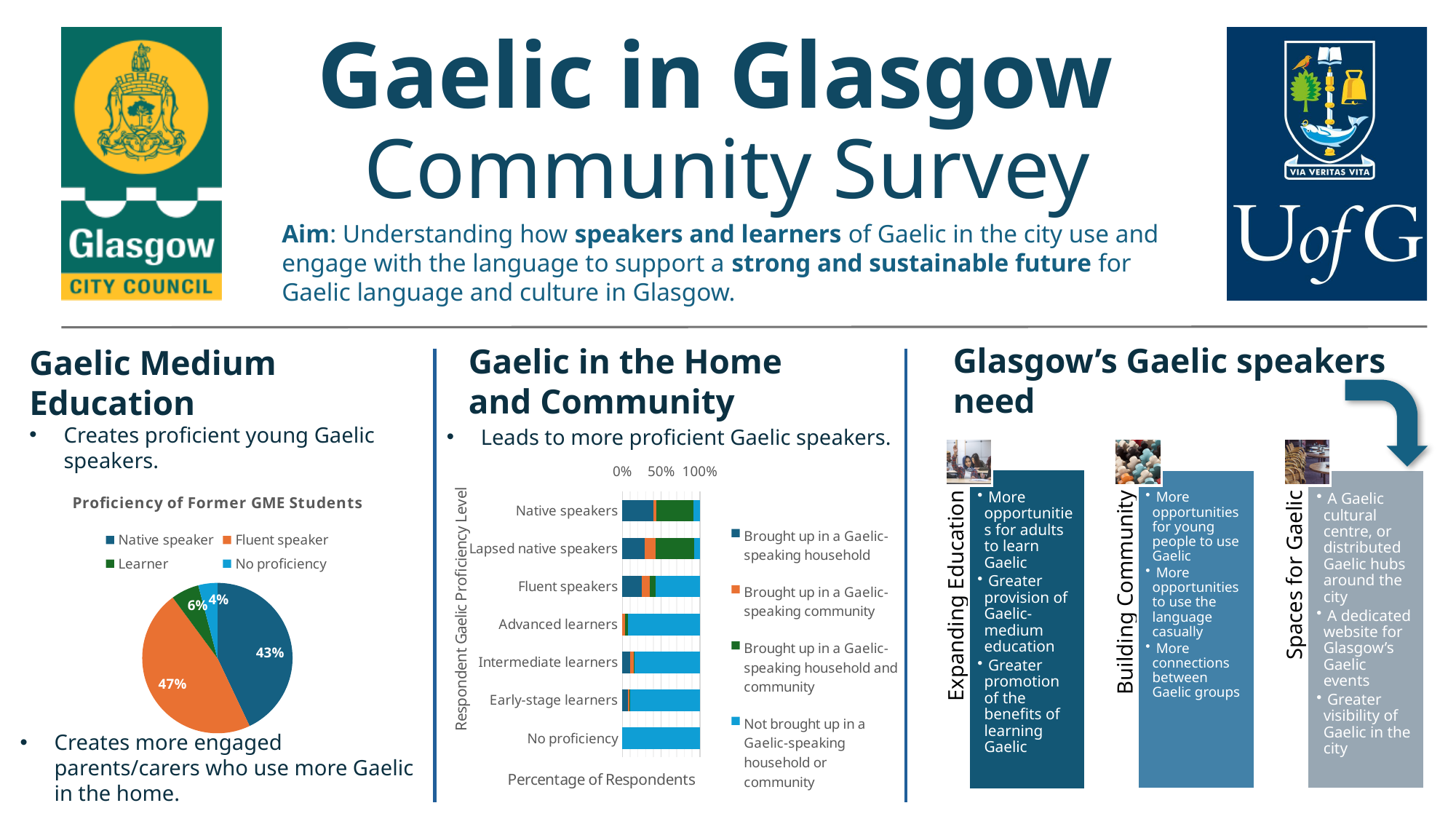
In the 'Proficiency of Former GME Students' pie chart, what percentage are Native speakers? 43% In the 'Proficiency of Former GME Students' pie chart, which is larger: Learner or No proficiency? Learner In the 'Proficiency of Former GME Students' pie chart, which category has the smallest share? No proficiency How many categories does the 'Proficiency of Former GME Students' pie chart show? 4 How many series does the legend of the stacked bar chart in the 'Gaelic in the Home and Community' section list? 4 In the 'Proficiency of Former GME Students' pie chart, which category has the largest share? Fluent speaker How many proficiency levels are listed on the y axis of the stacked bar chart in the 'Gaelic in the Home and Community' section? 7 In the 'Proficiency of Former GME Students' pie chart, what percentage have No proficiency? 4% In the 'Proficiency of Former GME Students' pie chart, what is the difference between the Fluent speaker and Native speaker shares? 4% What type of chart is used in the 'Gaelic in the Home and Community' section? Stacked bar chart In the stacked bar chart in the 'Gaelic in the Home and Community' section, is the 'Not brought up in a Gaelic-speaking household or community' value for Advanced learners greater or less than 50%? greater In the 'Proficiency of Former GME Students' pie chart, what percentage are Fluent speakers? 47%